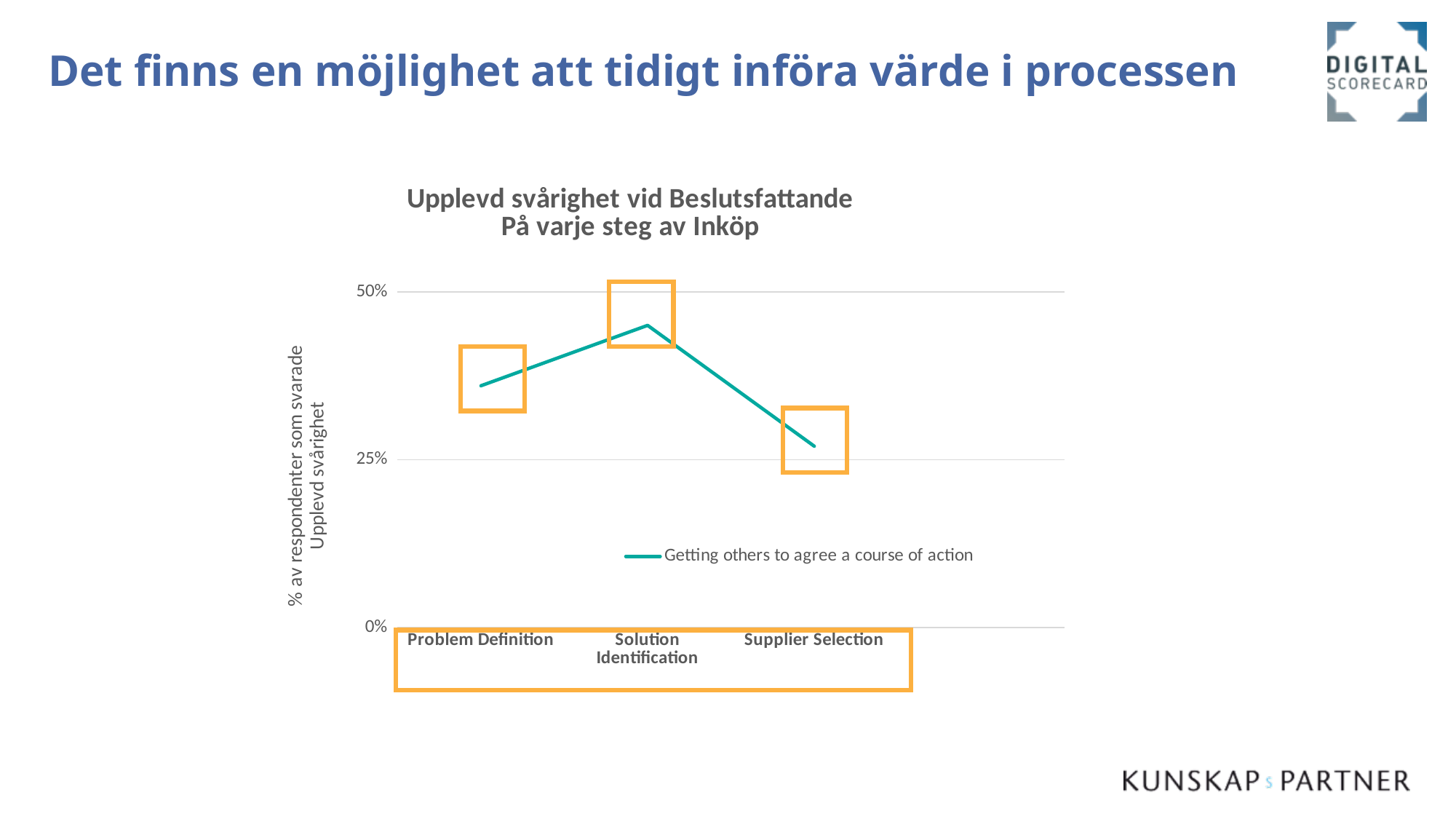
Which is larger, the value for Problem Definition or the value for Supplier Selection? Problem Definition Which category has the lowest value in the chart? Supplier Selection How many categories are shown on the x axis of the chart? 3 How do the values change from Problem Definition to Supplier Selection along the x axis? rise then fall What is the title of the chart? Upplevd svårighet vid Beslutsfattande På varje steg av Inköp What kind of chart is shown on the slide? line chart What is the name of the series listed in the chart's legend? Getting others to agree a course of action Is the value for Supplier Selection greater or less than 50%? less Is the value for Solution Identification greater or less than 50%? less Is the value for Problem Definition greater or less than 25%? greater How many series does the chart's legend list? 1 Which category has the highest value in the chart? Solution Identification